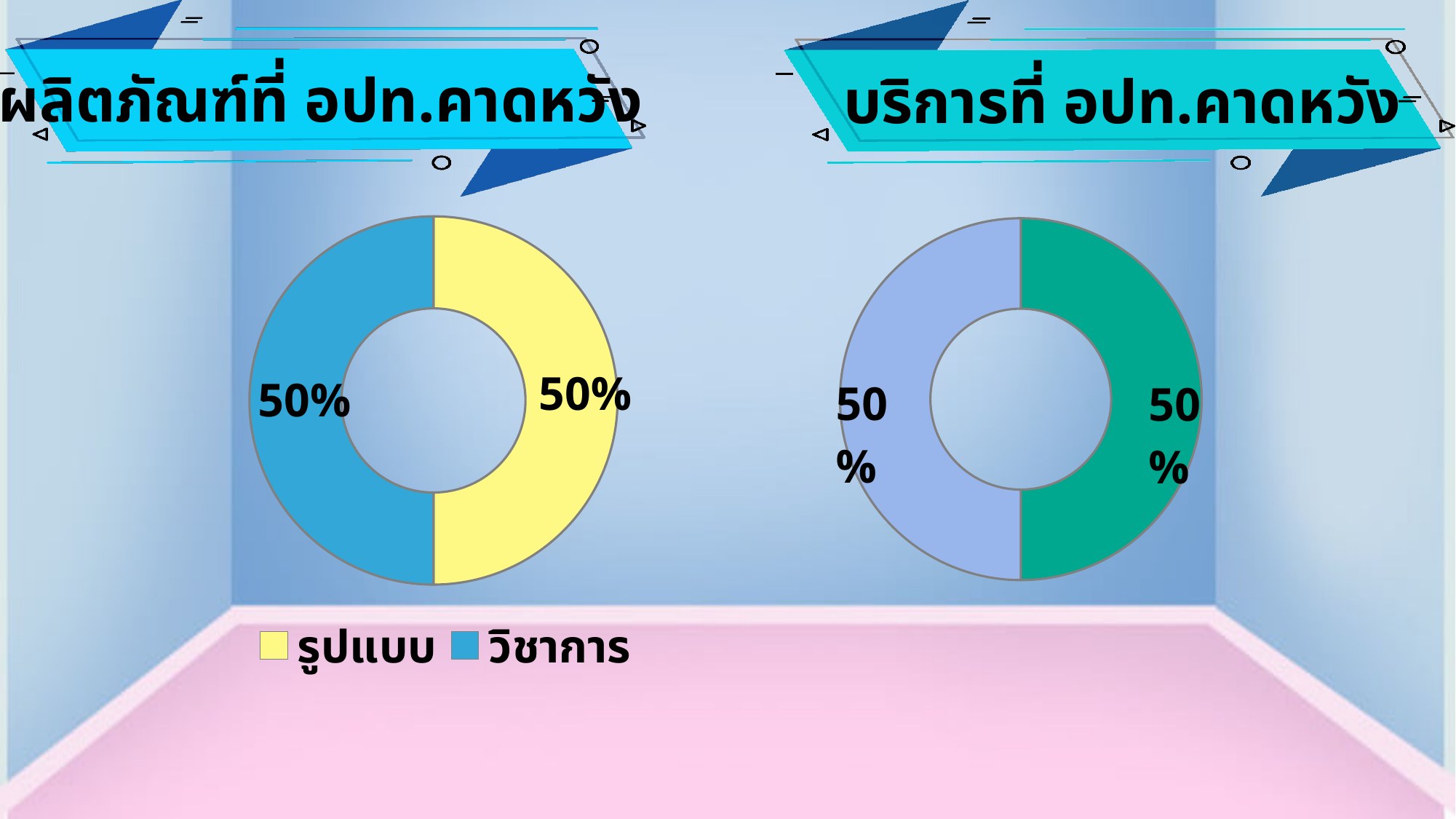
In the chart titled "บริการที่ อปท.คาดหวัง", what is the value shown on the green slice? 50% In the chart titled "ผลิตภัณฑ์ที่ อปท.คาดหวัง", what kind of chart is shown? Doughnut chart In the chart titled "บริการที่ อปท.คาดหวัง", what is the value shown on the light blue slice? 50% In the chart titled "ผลิตภัณฑ์ที่ อปท.คาดหวัง", what is the difference between the values for รูปแบบ and วิชาการ? 0% In the chart titled "ผลิตภัณฑ์ที่ อปท.คาดหวัง", what is the value for รูปแบบ? 50% In the chart titled "ผลิตภัณฑ์ที่ อปท.คาดหวัง", what is the value for วิชาการ? 50% In the chart titled "ผลิตภัณฑ์ที่ อปท.คาดหวัง", what share of the doughnut does รูปแบบ take? 50% In the chart titled "ผลิตภัณฑ์ที่ อปท.คาดหวัง", how many entries does the legend list? 2 In the chart titled "ผลิตภัณฑ์ที่ อปท.คาดหวัง", which colour represents รูปแบบ in the legend? Yellow In the chart titled "บริการที่ อปท.คาดหวัง", how many slices does the doughnut have? 2 In the chart titled "ผลิตภัณฑ์ที่ อปท.คาดหวัง", how many slices does the doughnut have? 2 In the chart titled "บริการที่ อปท.คาดหวัง", what kind of chart is shown? Doughnut chart